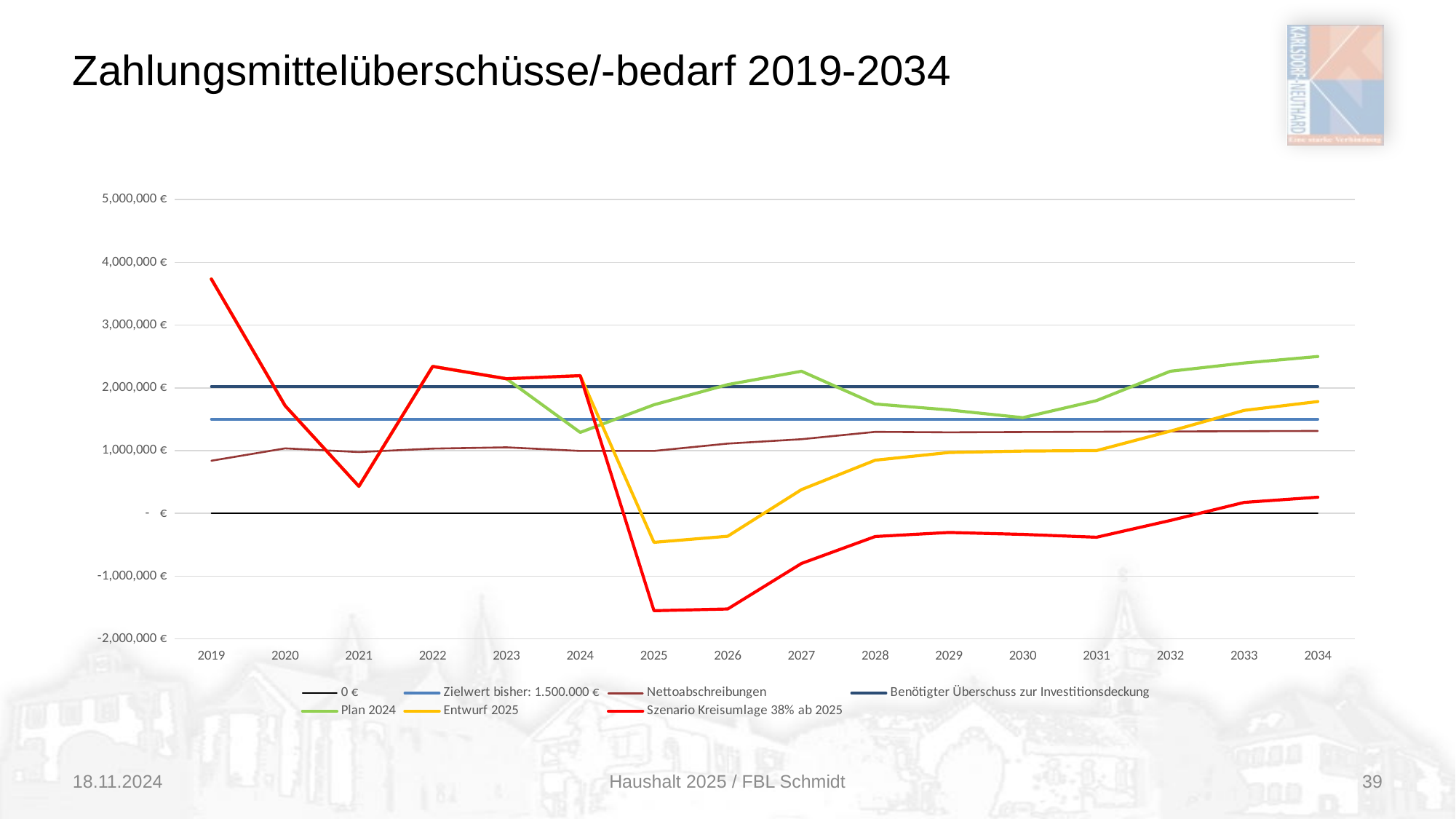
Is the value of the Plan 2024 line in 2034 greater or less than 2,000,000 €? greater Does the Szenario Kreisumlage 38% ab 2025 line rise or fall from 2026 to 2034? rise Is the value of the Szenario Kreisumlage 38% ab 2025 line in 2019 greater or less than 3,000,000 €? greater How many series does the legend list? 7 In 2025, which line is higher: Plan 2024 or Entwurf 2025? Plan 2024 How many years are shown on the x axis? 16 What kind of chart is shown on the slide? line chart Is the value of the Szenario Kreisumlage 38% ab 2025 line in 2025 greater or less than -1,000,000 €? less In which year does the Szenario Kreisumlage 38% ab 2025 line reach its highest value? 2019 Which series is drawn as the yellow line? Entwurf 2025